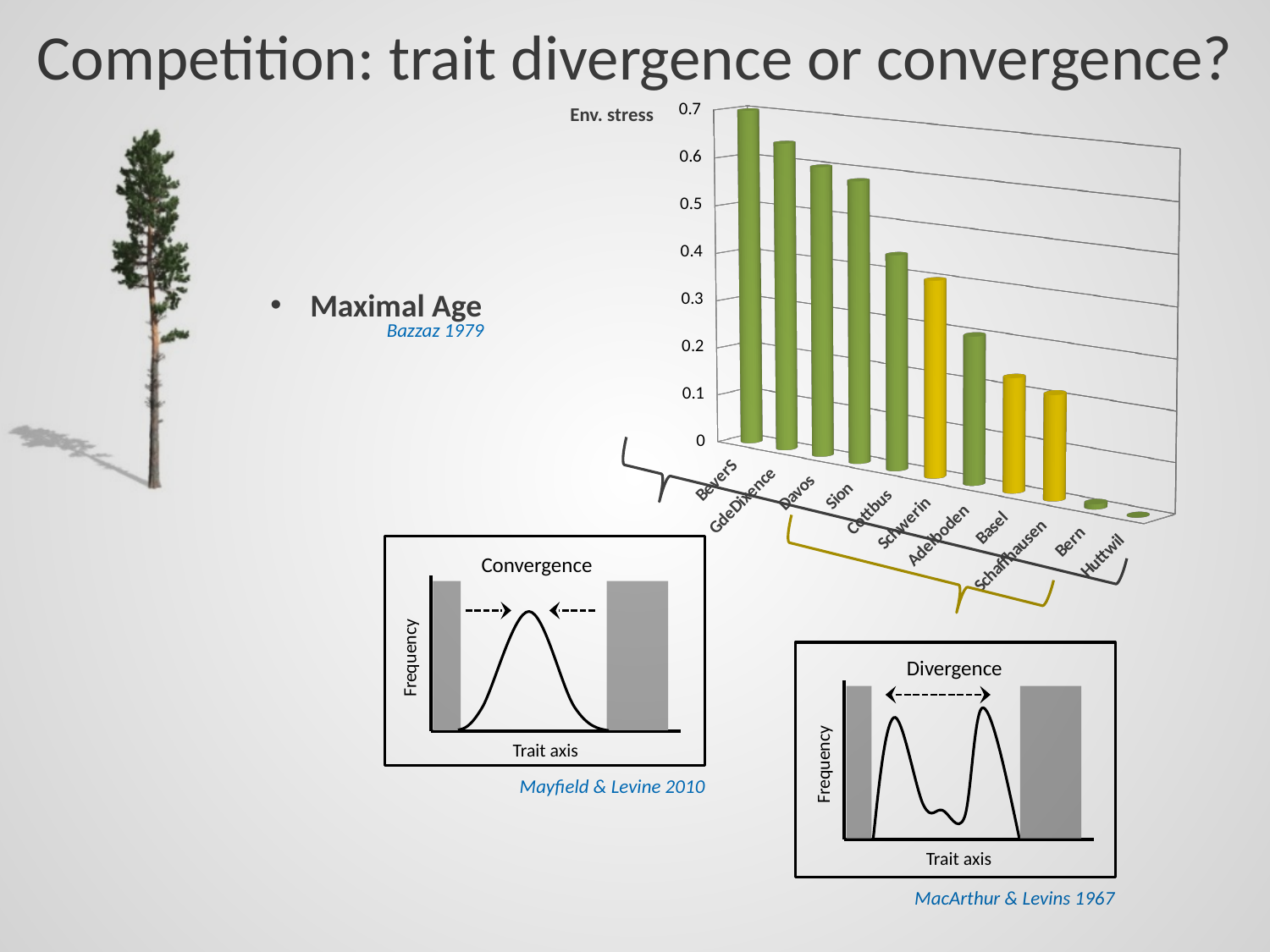
In the 'Env. stress' bar chart, what colour is the bar for Schwerin? yellow What is the label shown at the top of the vertical axis of the bar chart? Env. stress What kind of chart is the 'Env. stress' chart on the slide? bar chart In the 'Env. stress' bar chart, do the values rise or fall from left to right along the x axis? fall In the 'Env. stress' bar chart, is the value for Bevers greater or less than 0.6? greater How many categories are shown on the x axis of the 'Env. stress' bar chart? 11 In the 'Env. stress' bar chart, which category has the highest value? BeverS In the 'Env. stress' bar chart, which is larger, the value for Davos or the value for Cottbus? Davos In the 'Env. stress' bar chart, is the value for Schwerin greater or less than 0.2? greater In the 'Env. stress' bar chart, is the value for Cottbus greater or less than 0.5? less